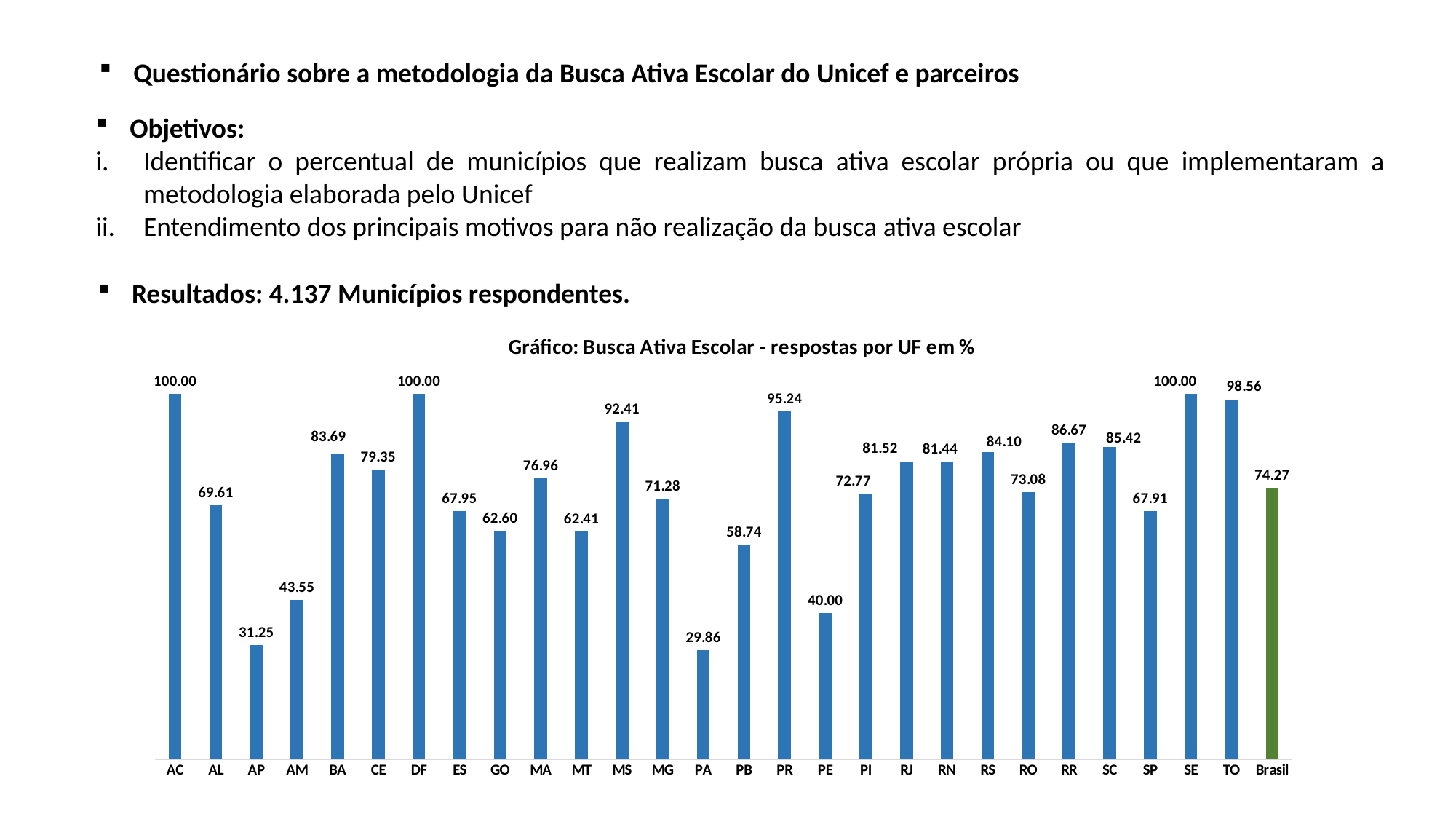
What is the value for MS in the chart? 92.41 What is the value for PE in the chart? 40.00 Which bar in the chart is coloured green instead of blue? Brasil Which category has the lowest value in the chart? PA Which is larger, the value for BA or the value for CE? BA How many categories are shown on the x axis of the chart? 28 What kind of chart is shown on the slide? Bar chart What is the difference between the values for PR and MS? 2.83 What is the value for Brasil in the chart? 74.27 What is the value for PA in the chart? 29.86 How many bars in the chart reach 100.00? 3 What is the difference between the values for TO and Brasil? 24.29